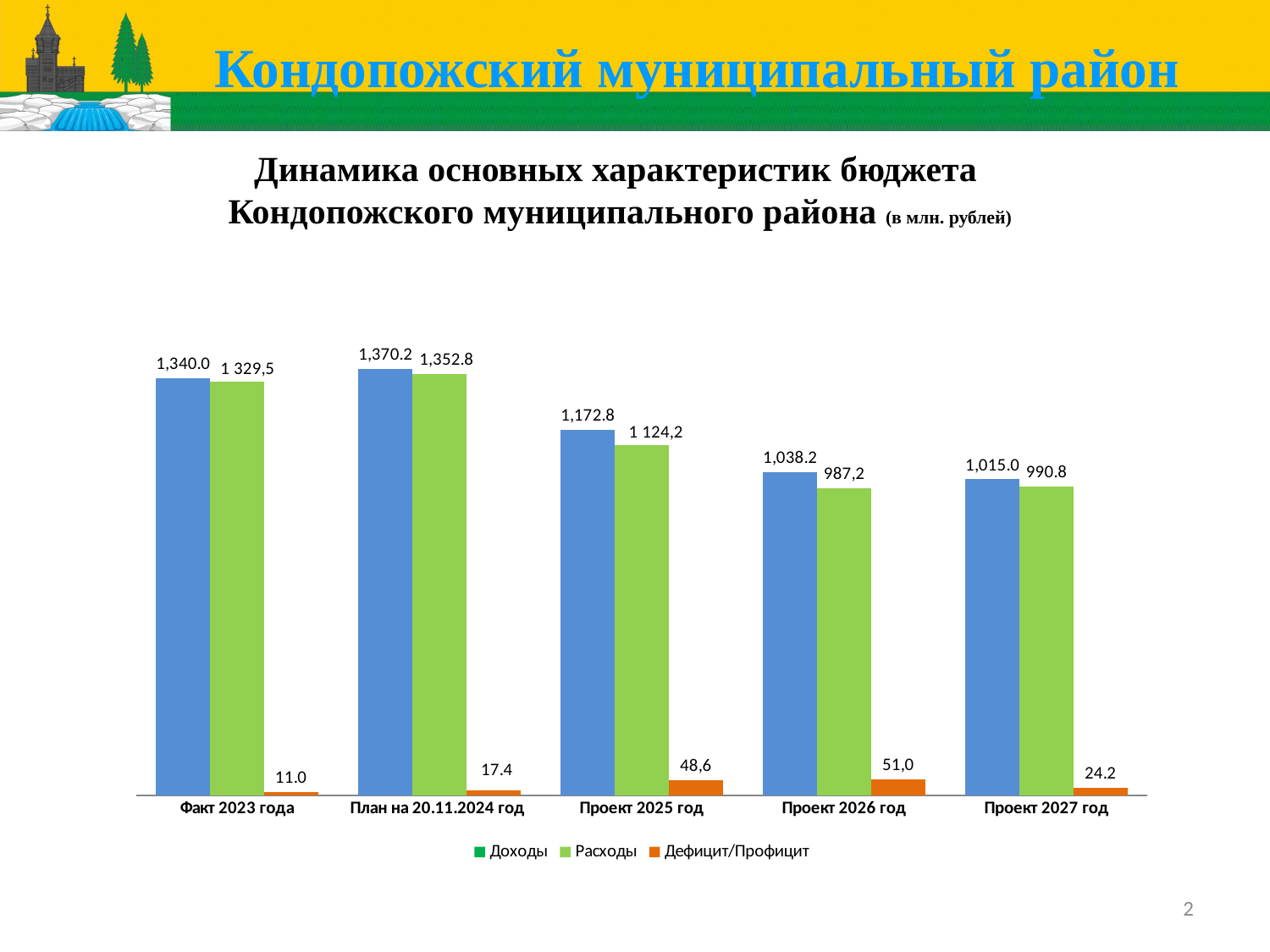
Which is larger: Доходы for Проект 2026 год or Доходы for Проект 2027 год? Проект 2026 год Do the values of Доходы rise or fall from План на 20.11.2024 год to Проект 2027 год? Fall Which category has the lowest value of Дефицит/Профицит? Факт 2023 года What is the value of Расходы for Проект 2025 год? 1 124,2 What is the value of Доходы for Факт 2023 года? 1,340.0 What is the value of Дефицит/Профицит for Проект 2026 год? 51,0 What is the difference between Доходы for План на 20.11.2024 год and Доходы for Факт 2023 года? 30.2 Which category has the highest value of Доходы? План на 20.11.2024 год What kind of chart is shown on the slide? Bar chart What is the value of Расходы for План на 20.11.2024 год? 1,352.8 How many series does the legend list? 3 How many categories are shown on the x axis? 5